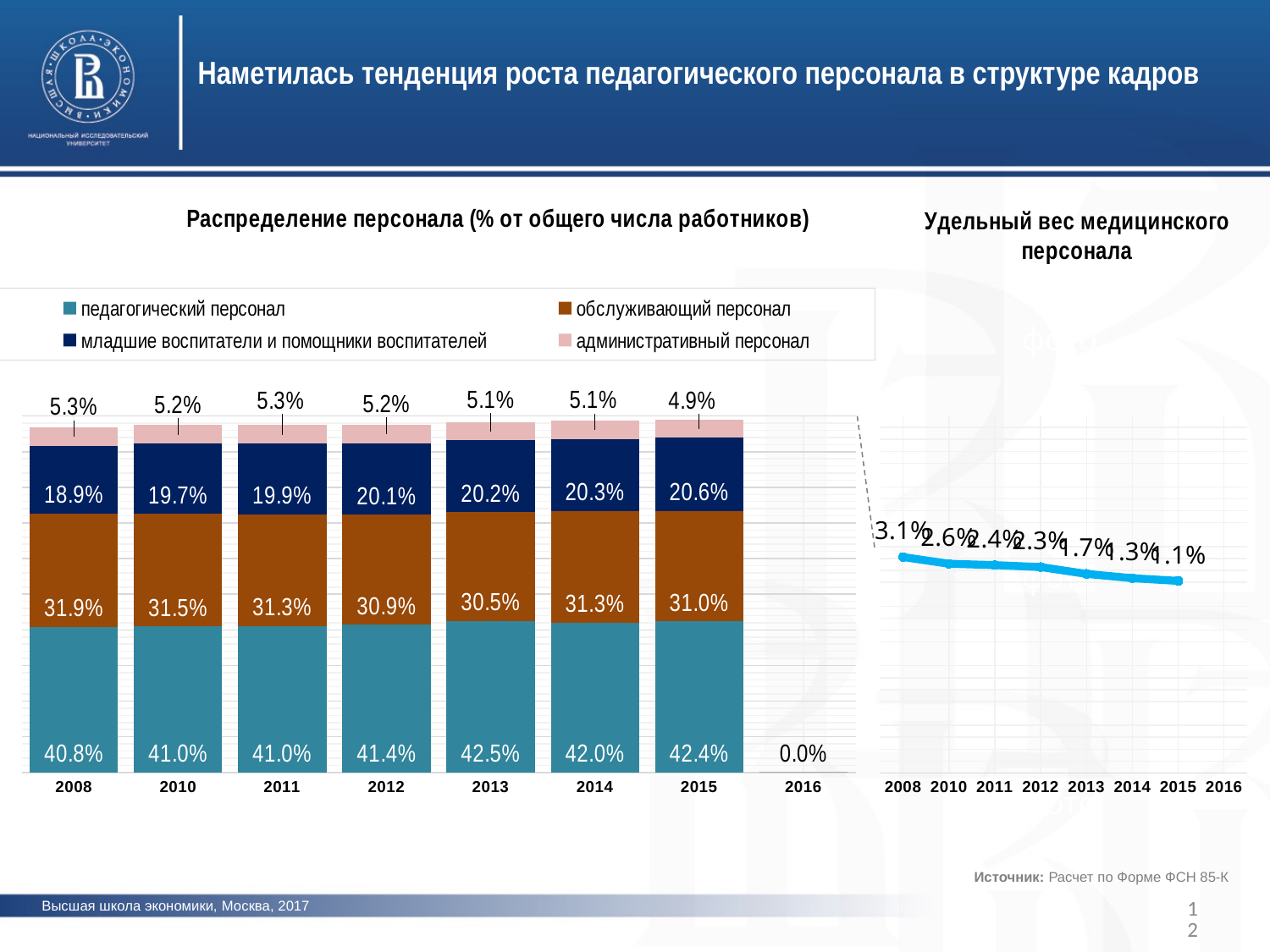
In the chart 'Распределение персонала (% от общего числа работников)', by how many percentage points did младшие воспитатели и помощники воспитателей change from 2008 to 2015? 1.7 percentage points In the chart 'Распределение персонала (% от общего числа работников)', in which year is the share of педагогический персонал highest? 2013 In the chart 'Распределение персонала (% от общего числа работников)', what is the total of the stacked bar for 2008? 96.9% In the chart 'Удельный вес медицинского персонала', what is the value for 2008? 3.1% In the chart 'Распределение персонала (% от общего числа работников)', is the share of обслуживающий персонал larger in 2008 or in 2015? 2008 In the chart 'Распределение персонала (% от общего числа работников)', what is the value for педагогический персонал in 2013? 42.5% In the chart 'Распределение персонала (% от общего числа работников)', in which year is the share of обслуживающий персонал lowest? 2013 In the chart 'Удельный вес медицинского персонала', do the values rise or fall from 2008 to 2015? Fall In the chart 'Распределение персонала (% от общего числа работников)', what is the value for административный персонал in 2015? 4.9% How many series does the legend of the chart 'Распределение персонала (% от общего числа работников)' list? 4 What kind of chart is 'Распределение персонала (% от общего числа работников)'? Stacked bar chart In the chart 'Распределение персонала (% от общего числа работников)', does the share of младшие воспитатели и помощники воспитателей rise or fall from 2008 to 2015? Rise